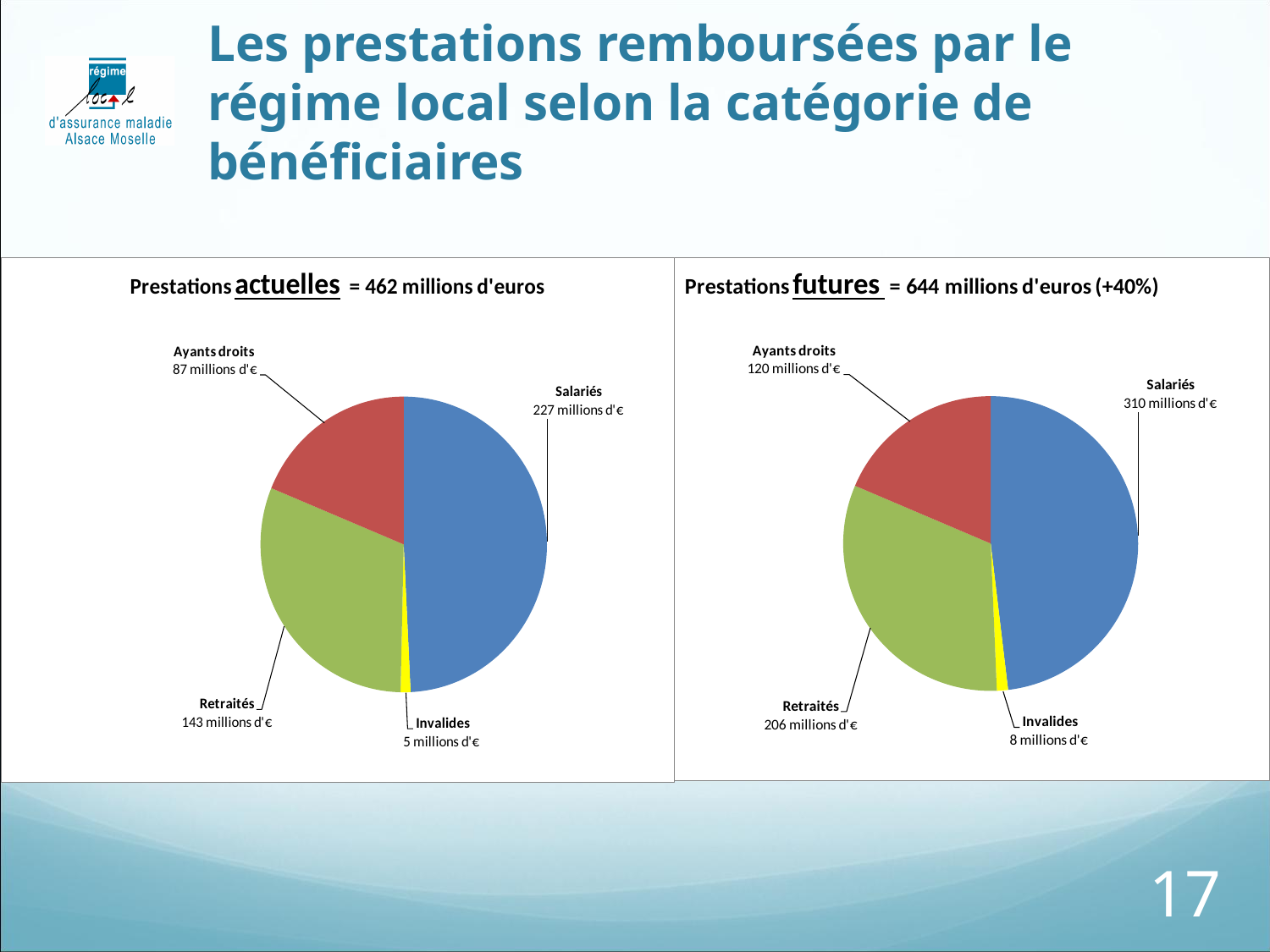
What total is stated in the title of the 'Prestations futures' chart? 644 millions d'euros In the 'Prestations futures' pie chart, which category has the largest slice? Salariés In the 'Prestations actuelles' pie chart, what colour is the Retraités slice? Green What type of chart is used on the left side of the slide? Pie chart In the 'Prestations actuelles' pie chart, what is the difference between Retraités and Ayants droits? 56 millions d'€ In the 'Prestations actuelles' pie chart, what is the value for Salariés? 227 millions d'€ In the 'Prestations futures' pie chart, what is the difference between Salariés and Retraités? 104 millions d'€ In the 'Prestations futures' pie chart, what is the value for Retraités? 206 millions d'€ In the 'Prestations actuelles' pie chart, which is larger, Retraités or Ayants droits? Retraités How many categories does the 'Prestations futures' pie chart show? 4 In the 'Prestations actuelles' pie chart, what is the value for Invalides? 5 millions d'€ In the 'Prestations actuelles' pie chart, which category has the smallest slice? Invalides